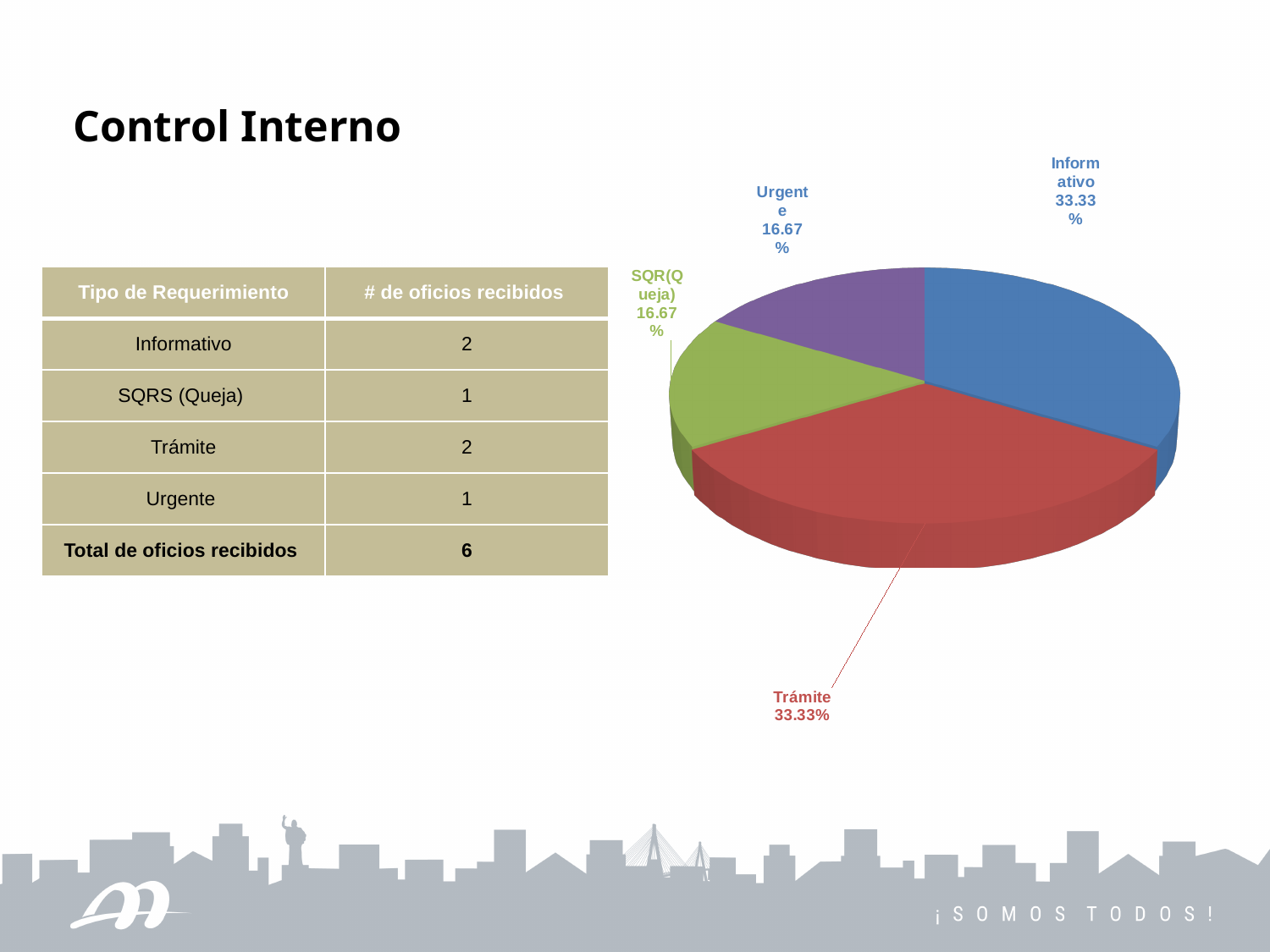
Which two slices of the pie chart share the same percentage of 33.33%? Informativo and Trámite Which is larger in the pie chart, the SQR(Queja) slice or the Trámite slice? Trámite What share of the pie does the Urgente slice represent? 16.67% What share of the pie does the Informativo slice represent? 33.33% How many slices does the pie chart have? 4 What is the difference in percentage points between the Trámite slice and the Urgente slice? 16.66 What kind of chart is shown on the slide? pie chart What share of the pie does the Trámite slice represent? 33.33% Which is larger in the pie chart, the Informativo slice or the Urgente slice? Informativo What colour is the Trámite slice in the pie chart? red